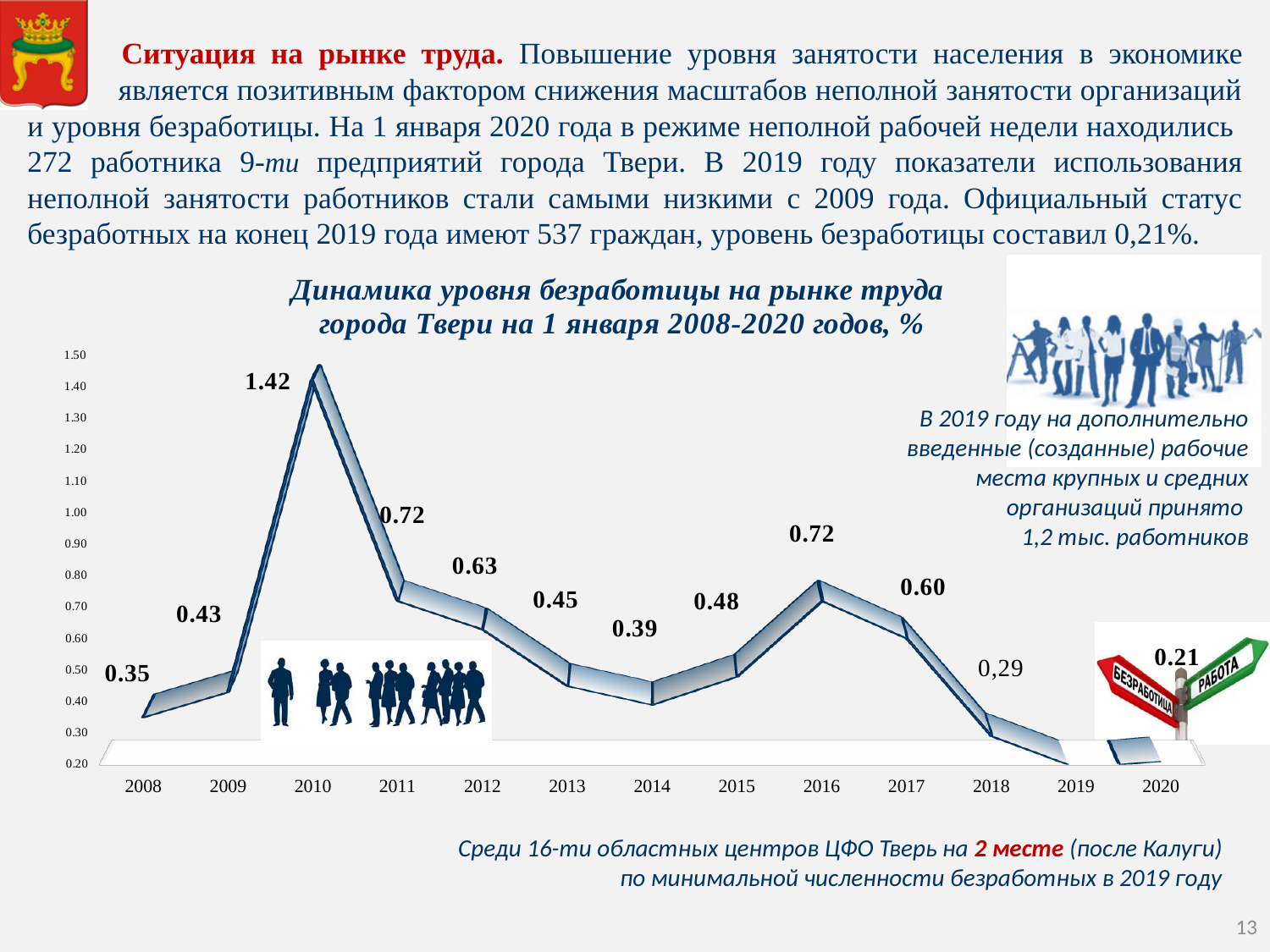
Which year has the larger value, 2012 or 2013? 2012 What kind of chart is shown on the slide? line chart What is the value shown for 2016? 0.72 What is the unemployment rate value shown for 2010? 1.42 What is the value shown for 2008? 0.35 Which year has the larger value, 2014 or 2015? 2015 What is the difference between the values for 2010 and 2011? 0.70 How many years are shown on the x axis of the chart? 13 What is the difference between the values for 2016 and 2017? 0.12 What is the value shown for 2018? 0,29 Which year has the highest unemployment rate on the chart? 2010 Does the unemployment rate rise or fall from 2010 to 2014? falls